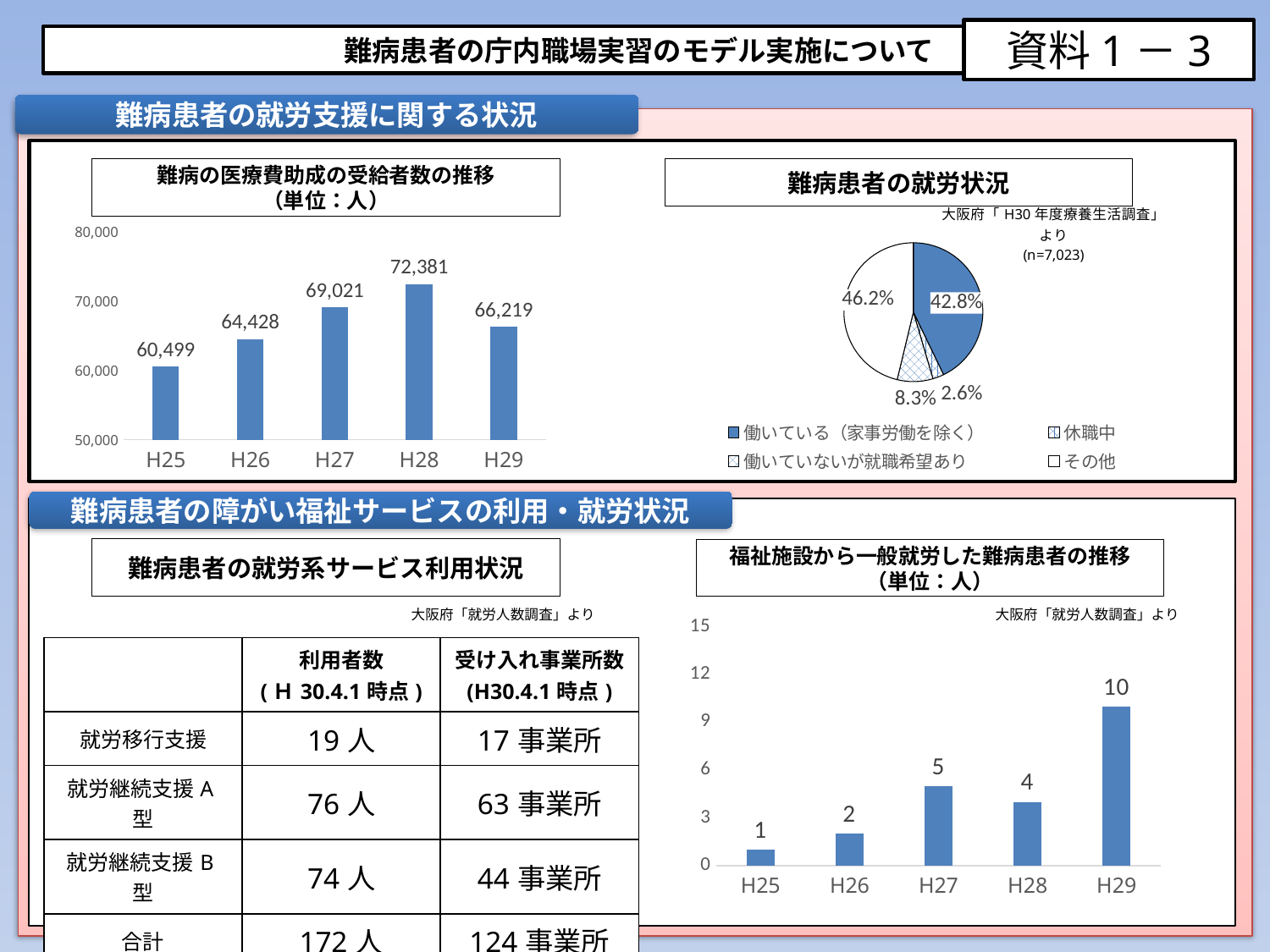
In the pie chart titled 難病患者の就労状況, what share is 働いている（家事労働を除く）? 42.8% In the chart titled 難病の医療費助成の受給者数の推移, what is the difference between the H28 and H29 values? 6,162 In the chart titled 福祉施設から一般就労した難病患者の推移, what is the difference between the H29 and H25 values? 9 What kind of chart is the one titled 福祉施設から一般就労した難病患者の推移? bar chart In the chart titled 難病の医療費助成の受給者数の推移, which year has the lowest value? H25 In the chart titled 難病の医療費助成の受給者数の推移, what is the value for H28? 72,381 In the pie chart titled 難病患者の就労状況, which category has the smallest share? 休職中 In the chart titled 福祉施設から一般就労した難病患者の推移, which is larger, the value for H27 or H28? H27 In the pie chart titled 難病患者の就労状況, how many categories does the legend list? 4 In the chart titled 難病の医療費助成の受給者数の推移, how many years are plotted? 5 In the chart titled 福祉施設から一般就労した難病患者の推移, what is the value for H29? 10 In the chart titled 難病の医療費助成の受給者数の推移, is the value for H27 greater or less than 70,000? less